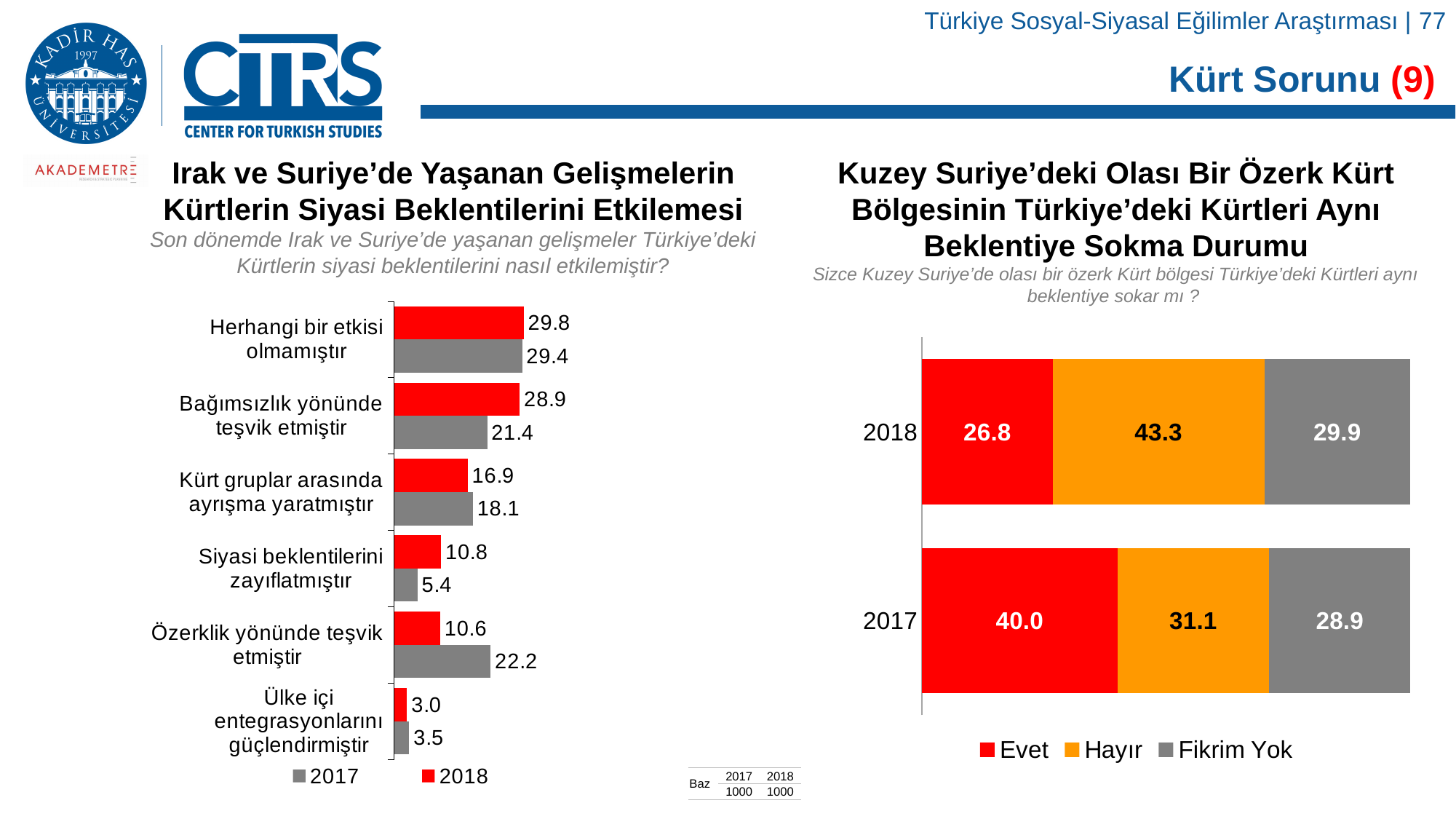
In the right chart, what is the total of the stacked bar for 2018? 100.0 In the left chart, what is the difference between the 2018 and 2017 values for 'Bağımsızlık yönünde teşvik etmiştir'? 7.5 In the left chart, what is the 2017 value for 'Özerklik yönünde teşvik etmiştir'? 22.2 How many categories does the left chart show? 6 In the right chart (Kuzey Suriye'deki Olası Bir Özerk Kürt Bölgesinin Türkiye'deki Kürtleri Aynı Beklentiye Sokma Durumu), what is the 'Evet' value for 2017? 40.0 In the left chart, is the 2017 or the 2018 value larger for 'Siyasi beklentilerini zayıflatmıştır'? 2018 How many series does the legend of the right chart list? 3 What kind of chart is the left chart? Bar chart In the left chart, which category has the highest 2017 value? Herhangi bir etkisi olmamıştır In the right chart, what is the 'Hayır' value for 2018? 43.3 In the left chart (Irak ve Suriye'de Yaşanan Gelişmelerin Kürtlerin Siyasi Beklentilerini Etkilemesi), what is the 2018 value for 'Herhangi bir etkisi olmamıştır'? 29.8 In the left chart, which category has the lowest 2018 value? Ülke içi entegrasyonlarını güçlendirmiştir